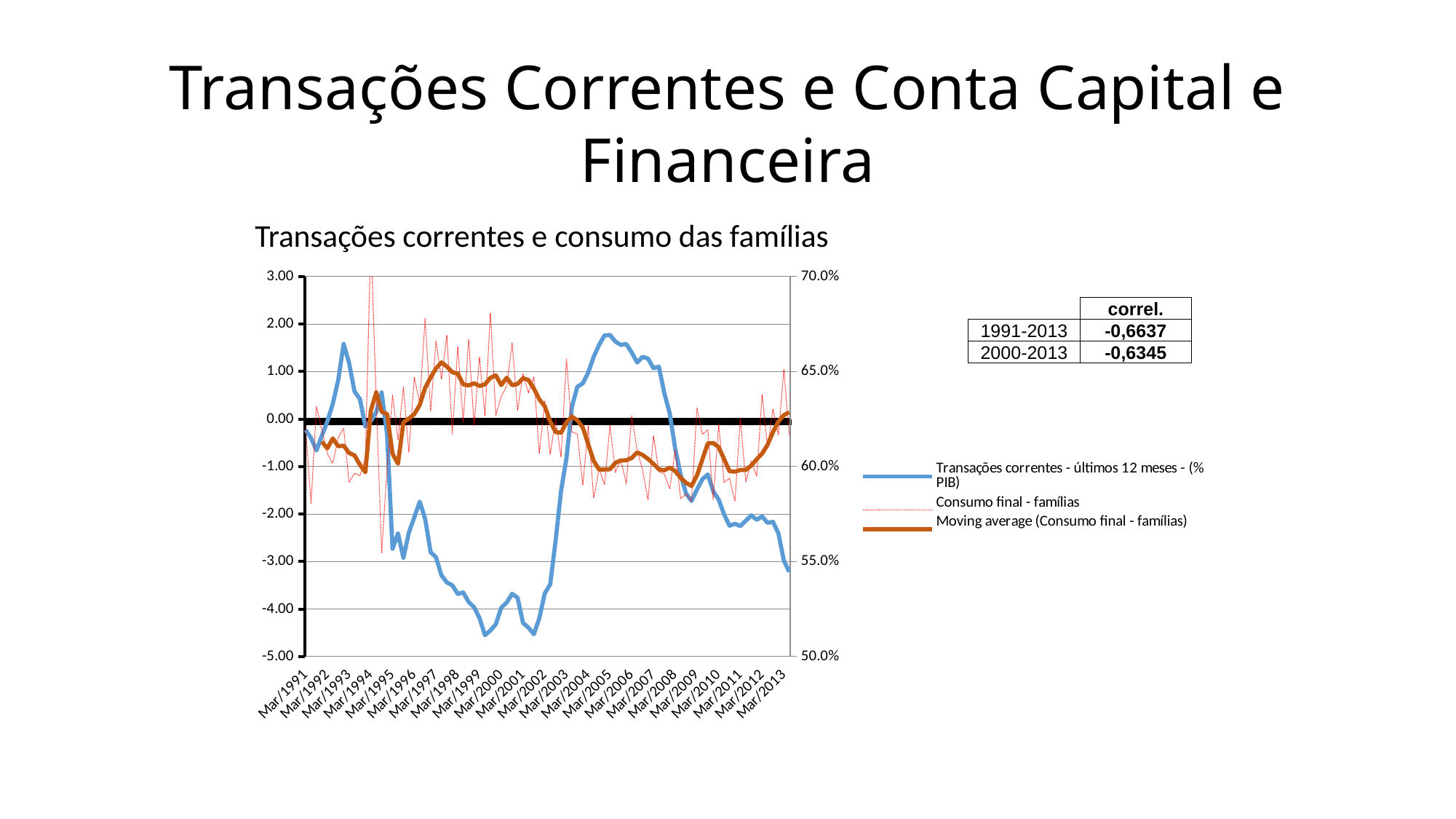
Does the Transações correntes - últimos 12 meses - (% PIB) line rise or fall between Mar/2002 and Mar/2005? rise Is the Moving average (Consumo final - famílias) at Mar/2006 greater or less than 65.0%? less Does the Transações correntes - últimos 12 meses - (% PIB) line rise or fall between Mar/2005 and Mar/2013? fall Is the value of Transações correntes - últimos 12 meses - (% PIB) at Mar/2013 greater or less than -2.00? less Which series in the legend is drawn as a thick orange line? Moving average (Consumo final - famílias) Is the value of Transações correntes - últimos 12 meses - (% PIB) at Mar/2005 greater or less than 1.00? greater How many date labels are shown along the x axis? 23 What is the title of the chart? Transações correntes e consumo das famílias Which is larger for Transações correntes - últimos 12 meses - (% PIB): the value at Mar/1993 or at Mar/2000? Mar/1993 How many series does the chart legend list? 3 What kind of chart is shown on the slide? line chart